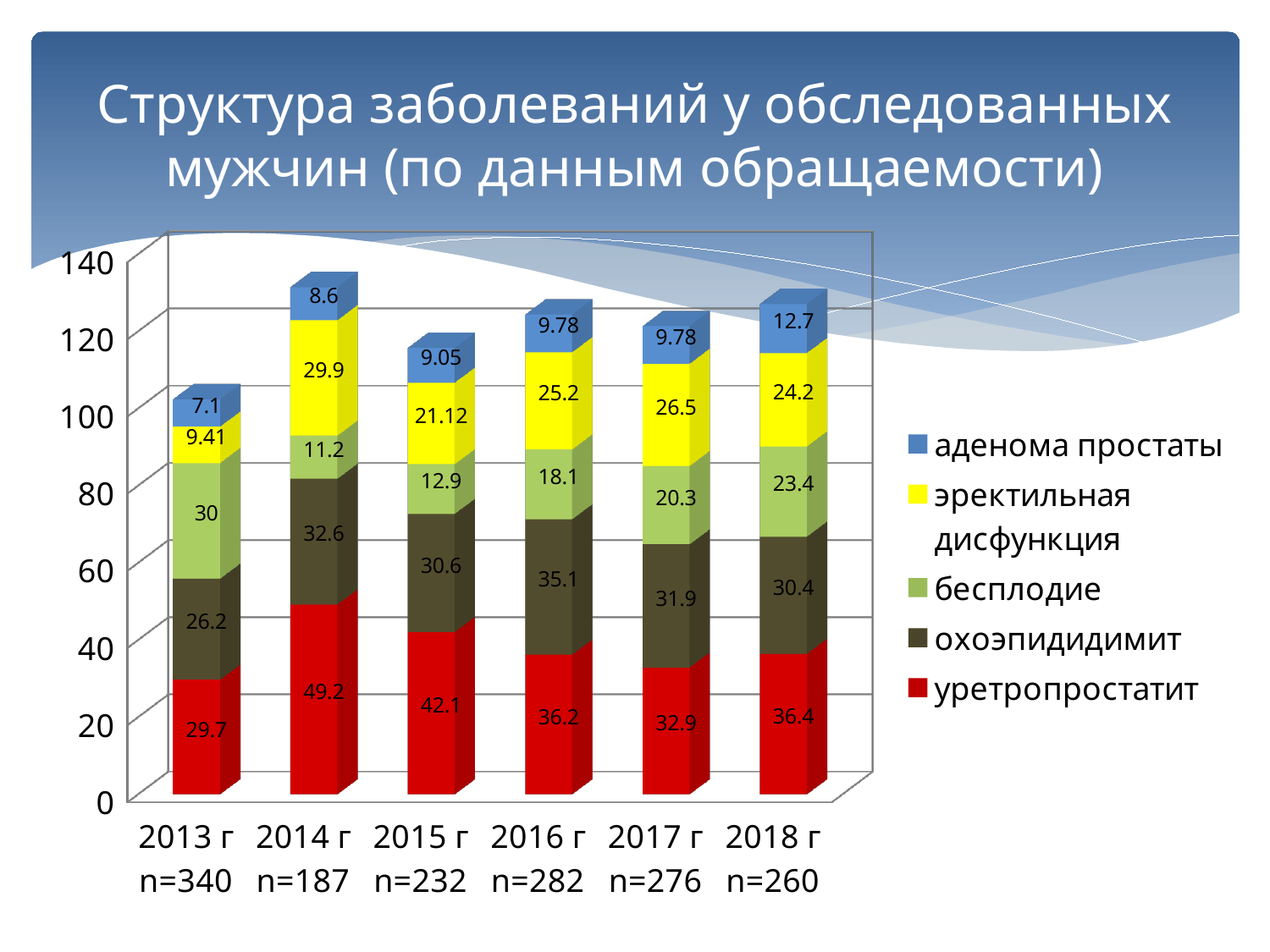
What is the difference between the бесплодие values for 2018 г and 2017 г? 3.1 How many series does the legend list? 5 What is the value for уретропростатит in 2014 г? 49.2 Which is larger: the охоэпидидимит value in 2016 г or in 2017 г? 2016 г What is the total of the stacked bar for 2014 г? 131.5 In which year is the уретропростатит value highest? 2014 г How many year categories are shown on the x axis? 6 In which year is the аденома простаты value lowest? 2013 г What is the value for бесплодие in 2013 г? 30 What is the value for аденома простаты in 2018 г? 12.7 What type of chart is shown on the slide? stacked bar chart What is the value for эректильная дисфункция in 2015 г? 21.12